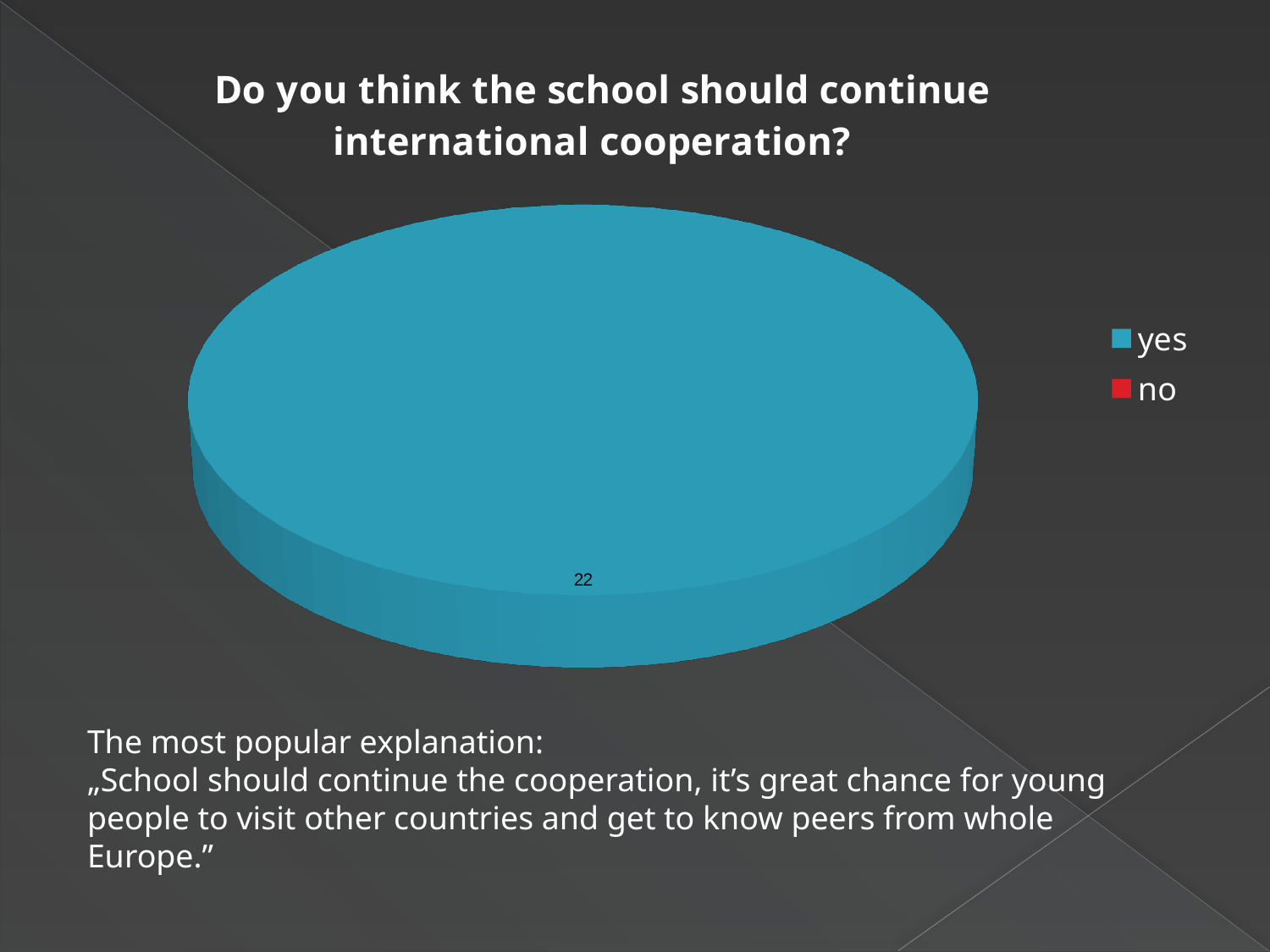
What is the value shown for "yes" in the pie chart? 22 Which category has the largest slice in the pie chart? yes What is the title of the chart? Do you think the school should continue international cooperation? How many entries does the legend of the pie chart list? 2 Which is larger in the pie chart, "yes" or "no"? yes What colour does the legend assign to "no"? red What kind of chart is shown on the slide? pie chart